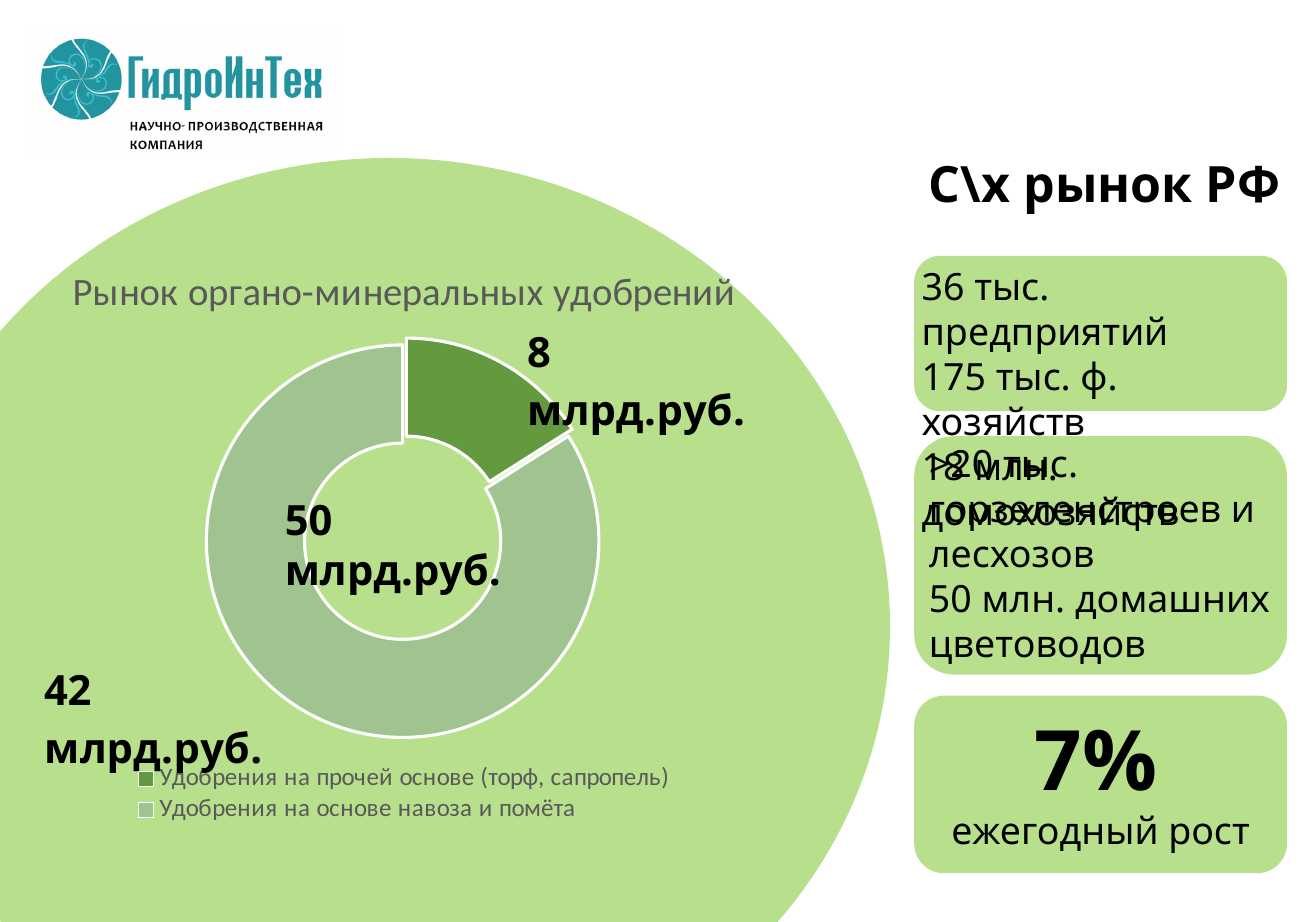
What value is shown for the dark green slice, 'Удобрения на прочей основе (торф, сапропель)'? 8 млрд.руб. What colour is the slice for 'Удобрения на прочей основе (торф, сапропель)'? dark green Which category has the smaller value in the chart? Удобрения на прочей основе (торф, сапропель) What is the title of the chart on the slide? Рынок органо-минеральных удобрений What total value is printed in the centre of the doughnut chart? 50 млрд.руб. How many entries does the chart legend list? 2 Which category has the larger value in the chart? Удобрения на основе навоза и помёта How many slices does the doughnut chart have? 2 What value is shown for the light green slice, 'Удобрения на основе навоза и помёта'? 42 млрд.руб. What is the difference between the value for 'Удобрения на основе навоза и помёта' and the value for 'Удобрения на прочей основе (торф, сапропель)'? 34 млрд.руб. What kind of chart is shown on the slide? doughnut (pie) chart Is the value for 'Удобрения на основе навоза и помёта' larger or smaller than the value for 'Удобрения на прочей основе (торф, сапропель)'? larger